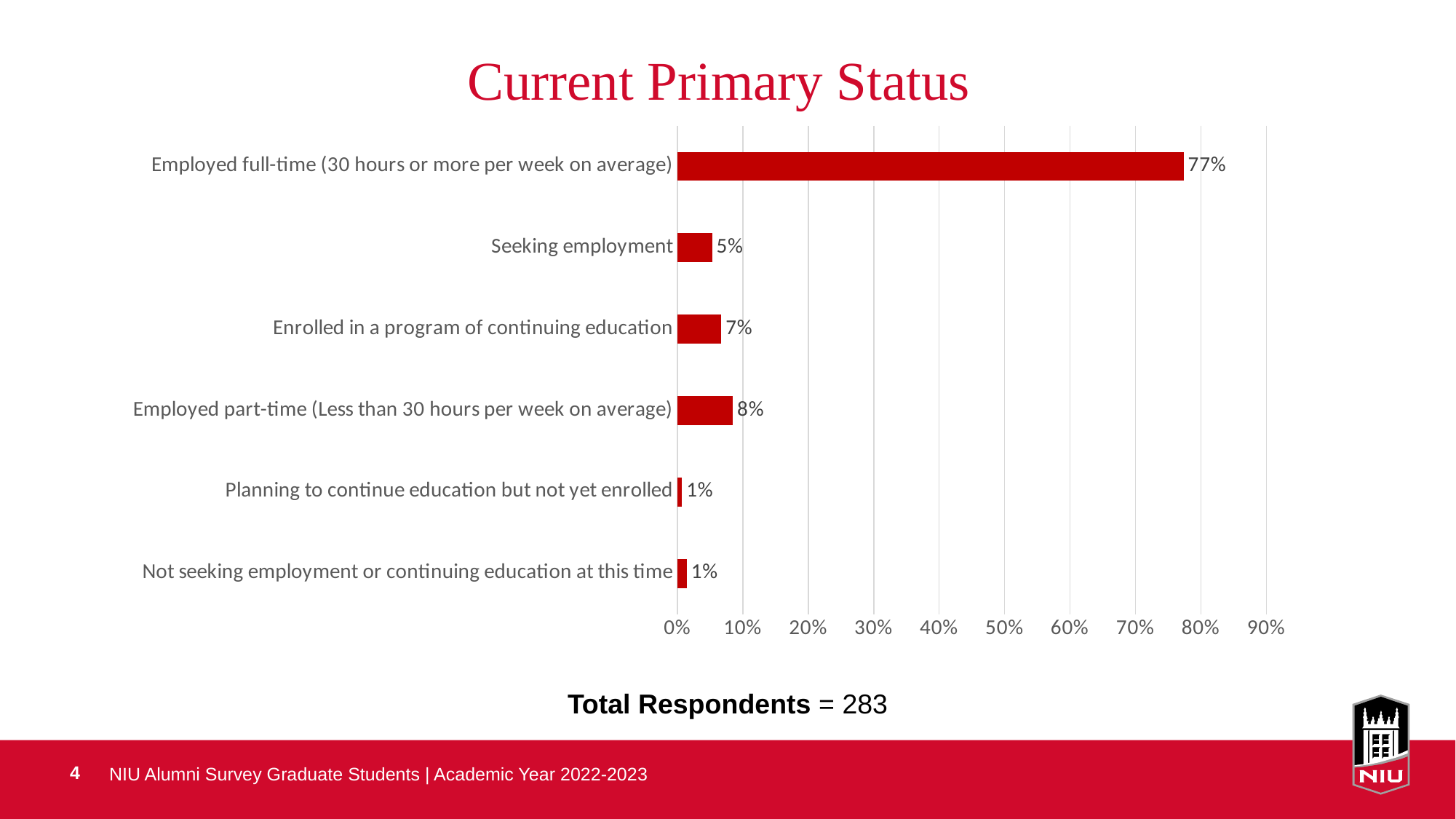
What is the title of the chart? Current Primary Status What percentage of respondents are employed full-time (30 hours or more per week on average)? 77% What percentage of respondents are enrolled in a program of continuing education? 7% What kind of chart is shown on the slide? Bar chart Which is larger: the percentage enrolled in a program of continuing education or the percentage seeking employment? Enrolled in a program of continuing education What is the total number of respondents stated on the slide? 283 What percentage of respondents are seeking employment? 5% Which category has the highest percentage? Employed full-time (30 hours or more per week on average) How many categories are shown in the chart? 6 What is the difference in percentage points between employed full-time and employed part-time? 69 Is the value for employed full-time greater or less than 70%? greater What percentage of respondents are employed part-time (less than 30 hours per week on average)? 8%